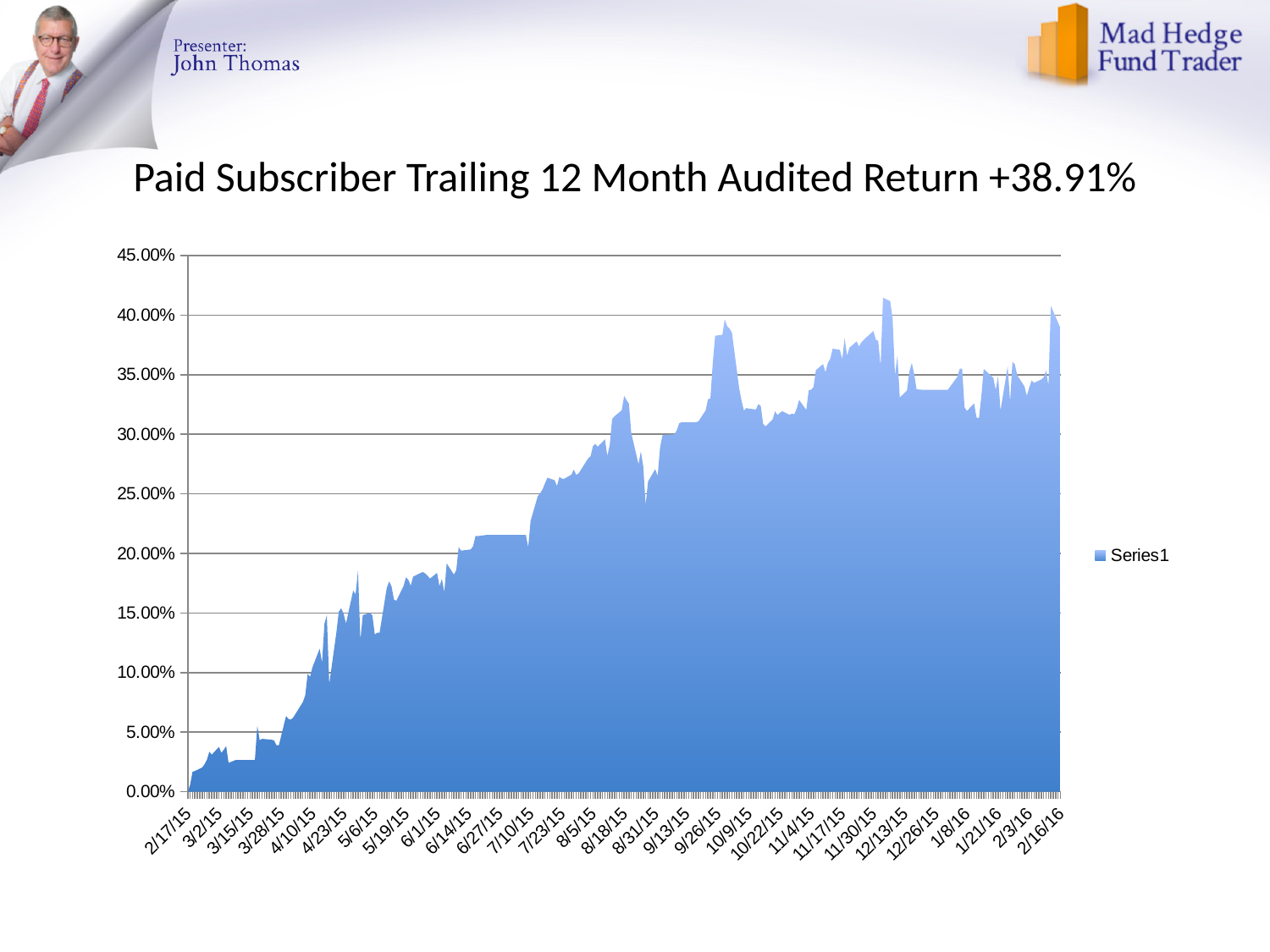
Is the value for 7/23/15 greater or less than 20.00%? greater Is the value for 2/16/16 greater or less than 35.00%? greater What kind of chart is shown on the slide? area chart How many series does the legend list? 1 Is the value for 3/15/15 greater or less than 10.00%? less Which is larger, the value for 6/27/15 or the value for 9/26/15? 9/26/15 What is the name of the series shown in the legend? Series1 Do the values generally rise or fall from 2/17/15 to 2/16/16? rise Which is larger, the value for 2/17/15 or the value for 2/16/16? 2/16/16 What is the title of the chart on the slide? Paid Subscriber Trailing 12 Month Audited Return +38.91%